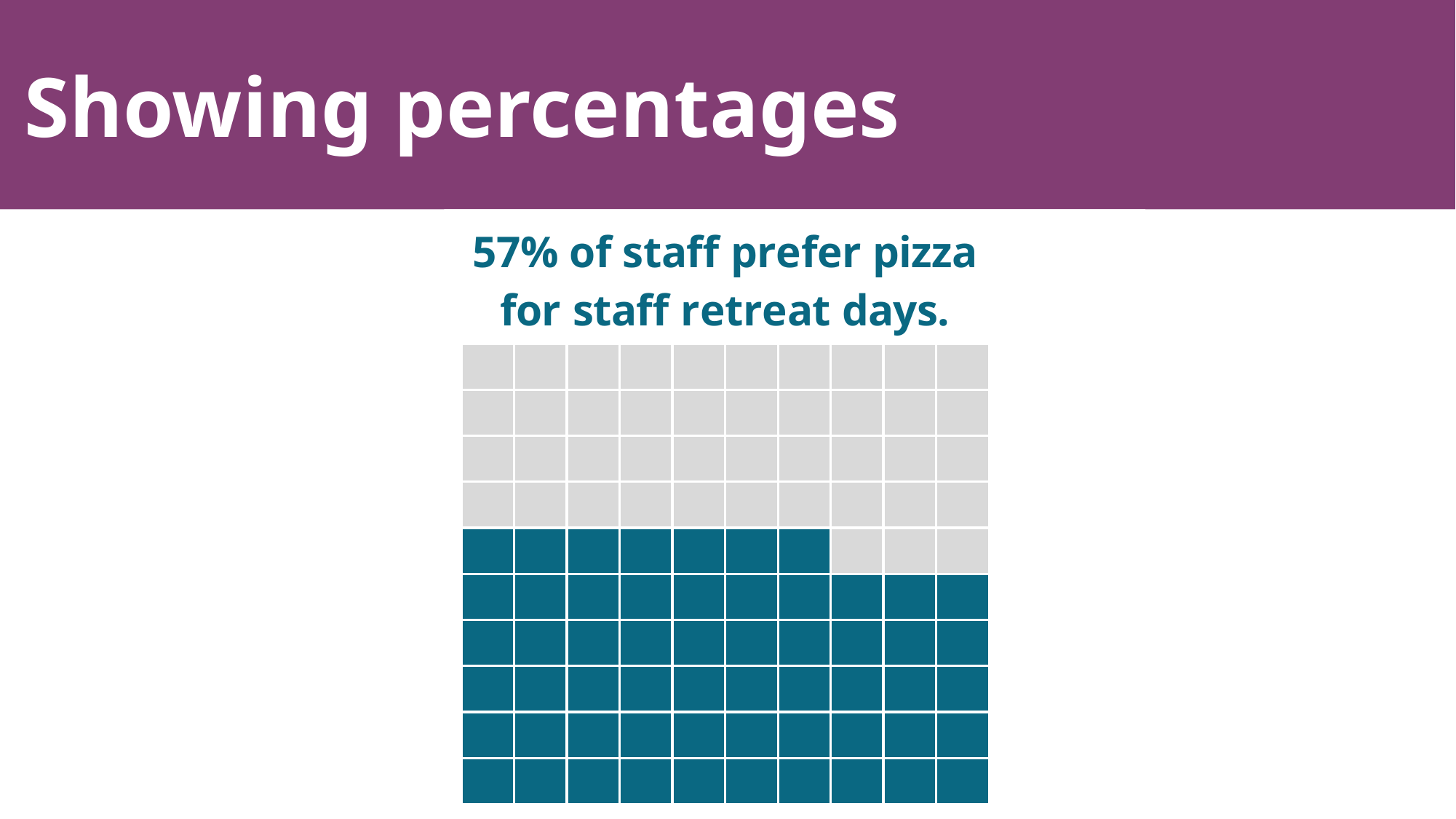
What is the title of the slide containing the chart? Showing percentages How many squares in the grid are left grey? 43 Is the share of staff who prefer pizza larger or smaller than the share who do not? larger What percentage of staff prefer pizza for staff retreat days, according to the chart? 57% Is the percentage of staff who prefer pizza greater or less than 50%? greater How many squares make up the grid in the chart? 100 What colour are the squares representing staff who prefer pizza? Teal How many squares in the grid are shaded teal? 57 What percentage of staff do not prefer pizza for staff retreat days, based on the chart? 43% What kind of chart is used to show the percentage of staff who prefer pizza? Waffle chart